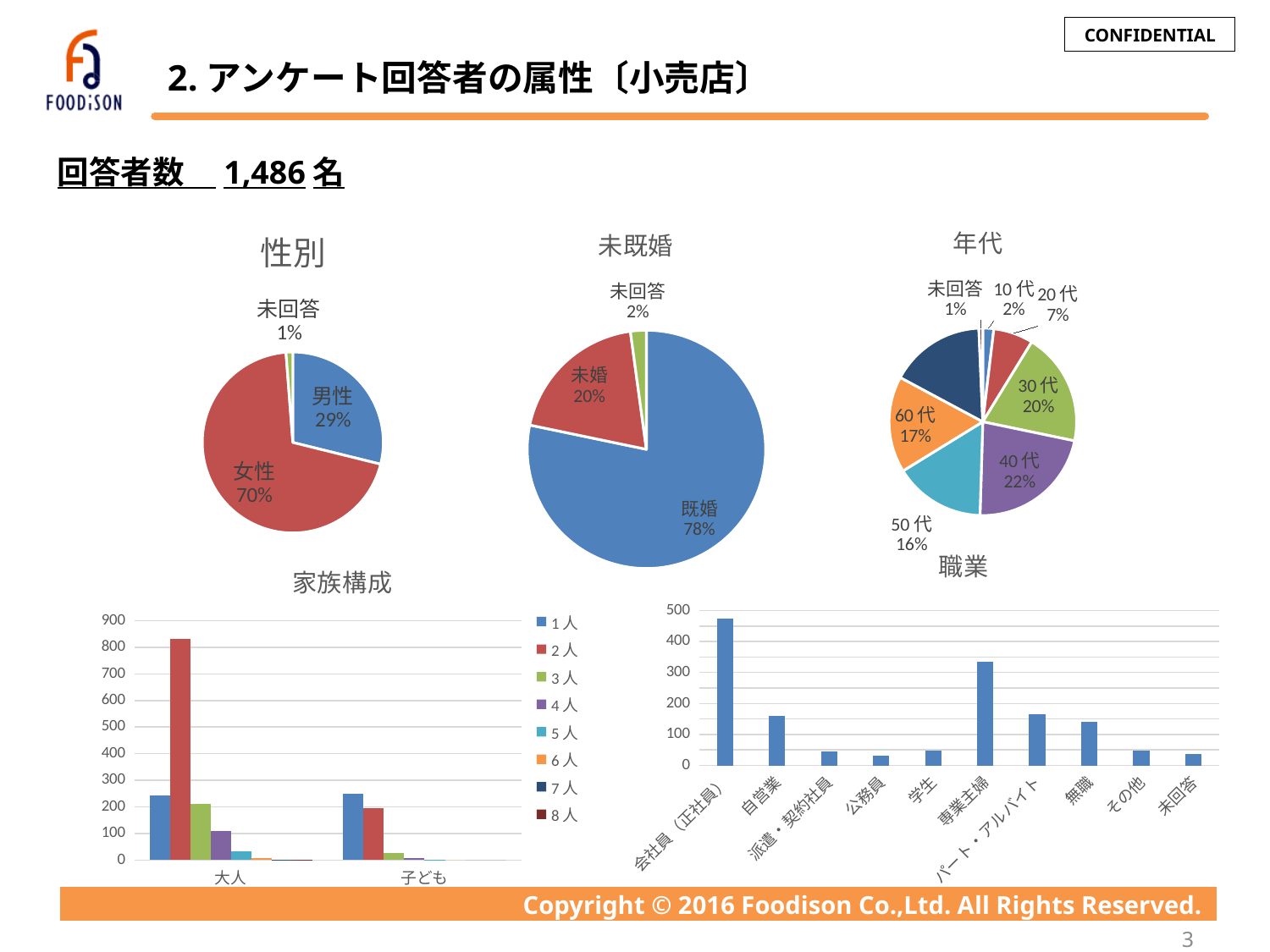
In the 性別 pie chart, what share is 男性? 29% How many categories are shown on the x axis of the 職業 chart? 10 In the 年代 pie chart, what share is 60代? 17% In the 性別 pie chart, what share is 女性? 70% In the 家族構成 chart, is the value for 2人 under 大人 greater or less than 800? greater In the 未既婚 pie chart, what is the difference in percentage points between 既婚 and 未婚? 58 In the 職業 chart, which category has the highest value? 会社員（正社員） How many series does the legend of the 家族構成 chart list? 8 In the 年代 pie chart, which is larger, 30代 or 50代? 30代 In the 年代 pie chart, which age group has the largest share? 40代 What kind of chart is the 職業 chart? bar chart